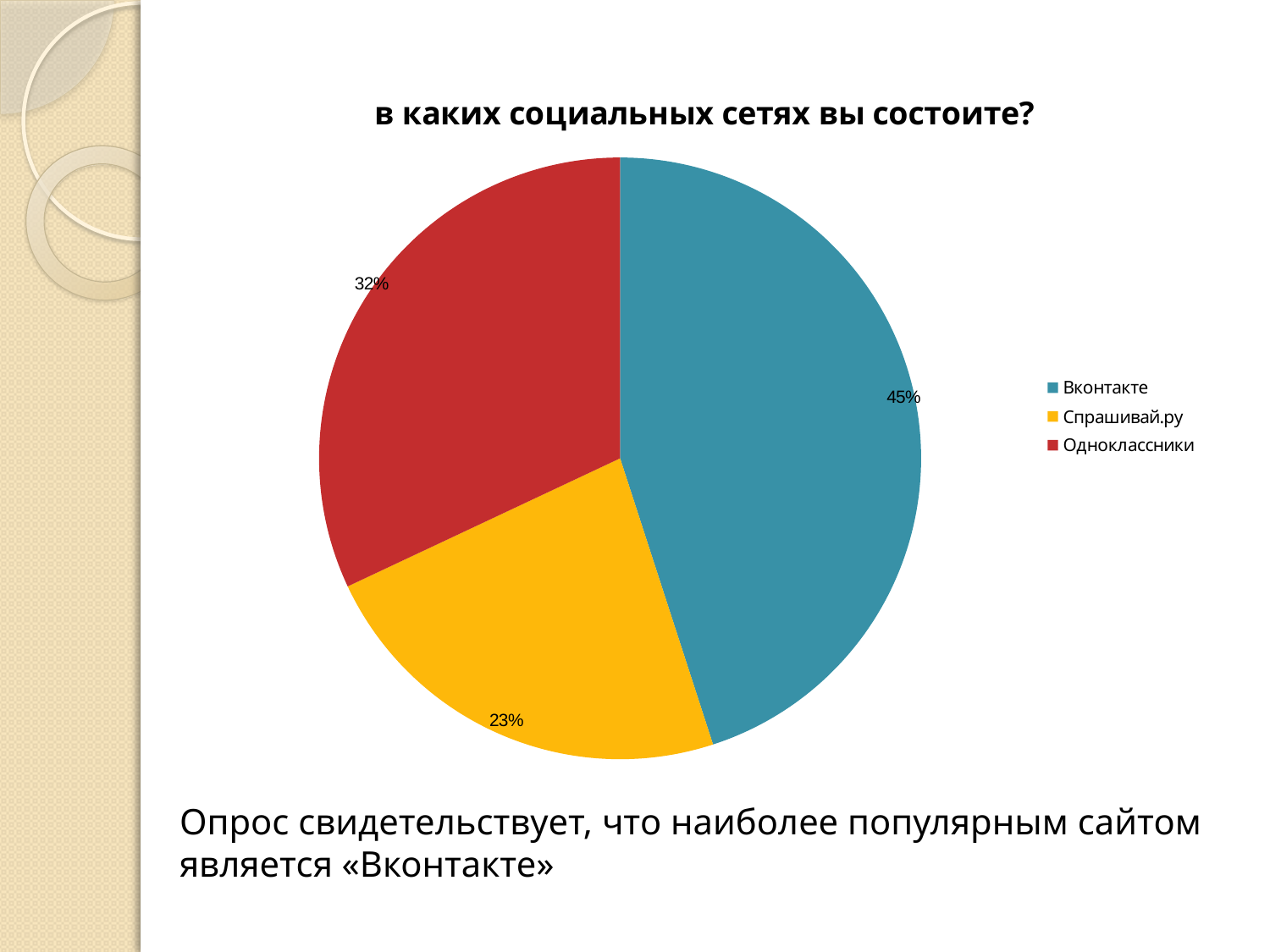
What colour is the Спрашивай.ру slice? yellow What is the difference in percentage points between Вконтакте and Одноклассники? 13 How many categories does the pie chart have? 3 Which is larger, the share for Одноклассники or the share for Спрашивай.ру? Одноклассники What is the title of the chart? в каких социальных сетях вы состоите? What percentage of the pie is Вконтакте? 45% How many entries does the legend list? 3 Which category has the largest share of the pie? Вконтакте What percentage of the pie is Спрашивай.ру? 23% What kind of chart is shown on the slide? pie chart Which category has the smallest share of the pie? Спрашивай.ру What percentage of the pie is Одноклассники? 32%